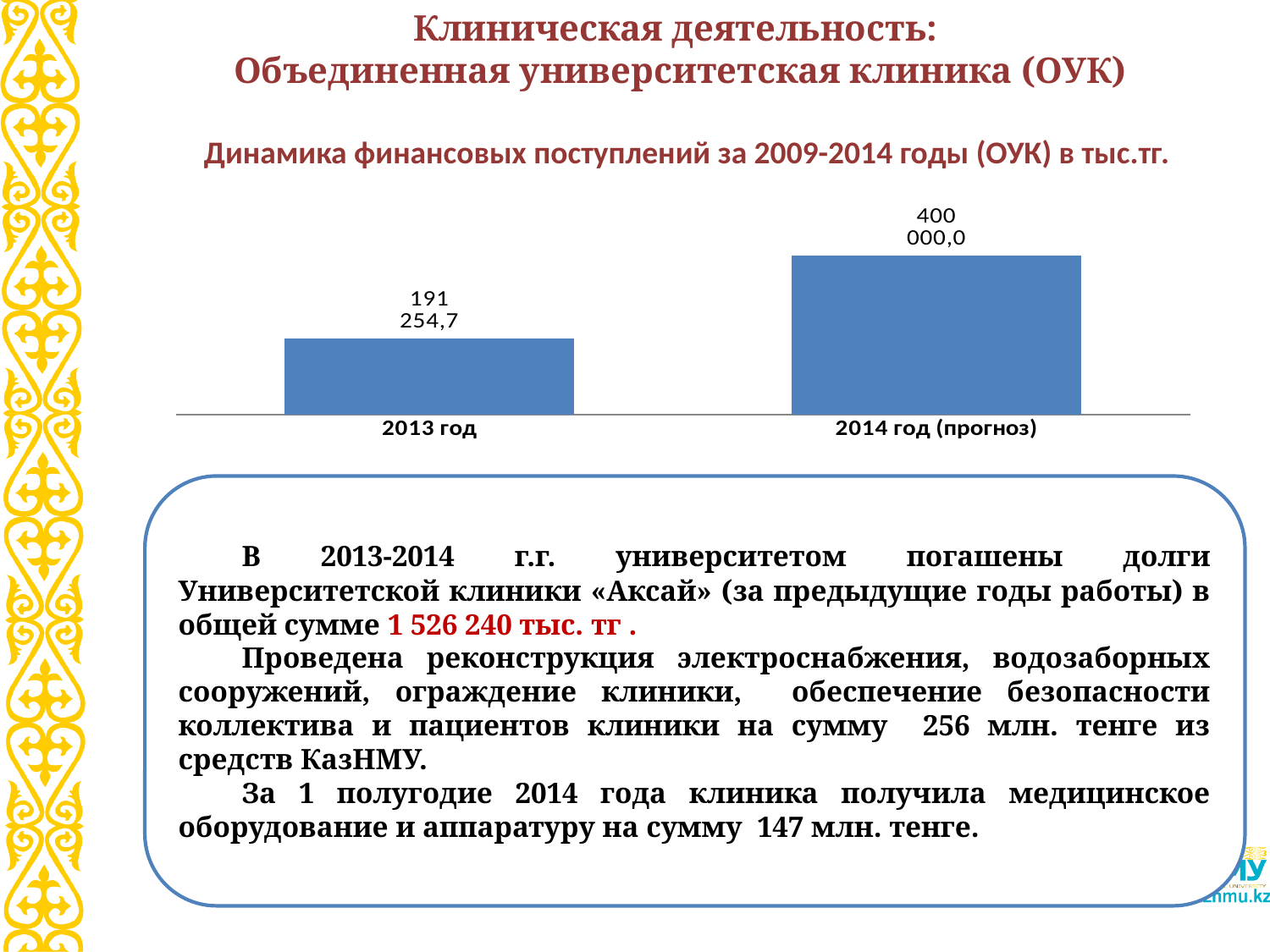
Which category has the highest value? 2014 год (прогноз) Which category has the lowest value? 2013 год What is the value shown for 2014 год (прогноз)? 400 000,0 Which is larger, the value for 2013 год or the value for 2014 год (прогноз)? 2014 год (прогноз) What kind of chart is shown on the slide? Bar chart What is the difference between the values for 2014 год (прогноз) and 2013 год? 208 745,3 How many categories are shown on the chart? 2 What is the value shown for 2013 год? 191 254,7 What colour are the bars in the chart? Blue Do the values rise or fall from 2013 год to 2014 год (прогноз)? Rise What is the title of the chart? Динамика финансовых поступлений за 2009-2014 годы (ОУК) в тыс.тг.